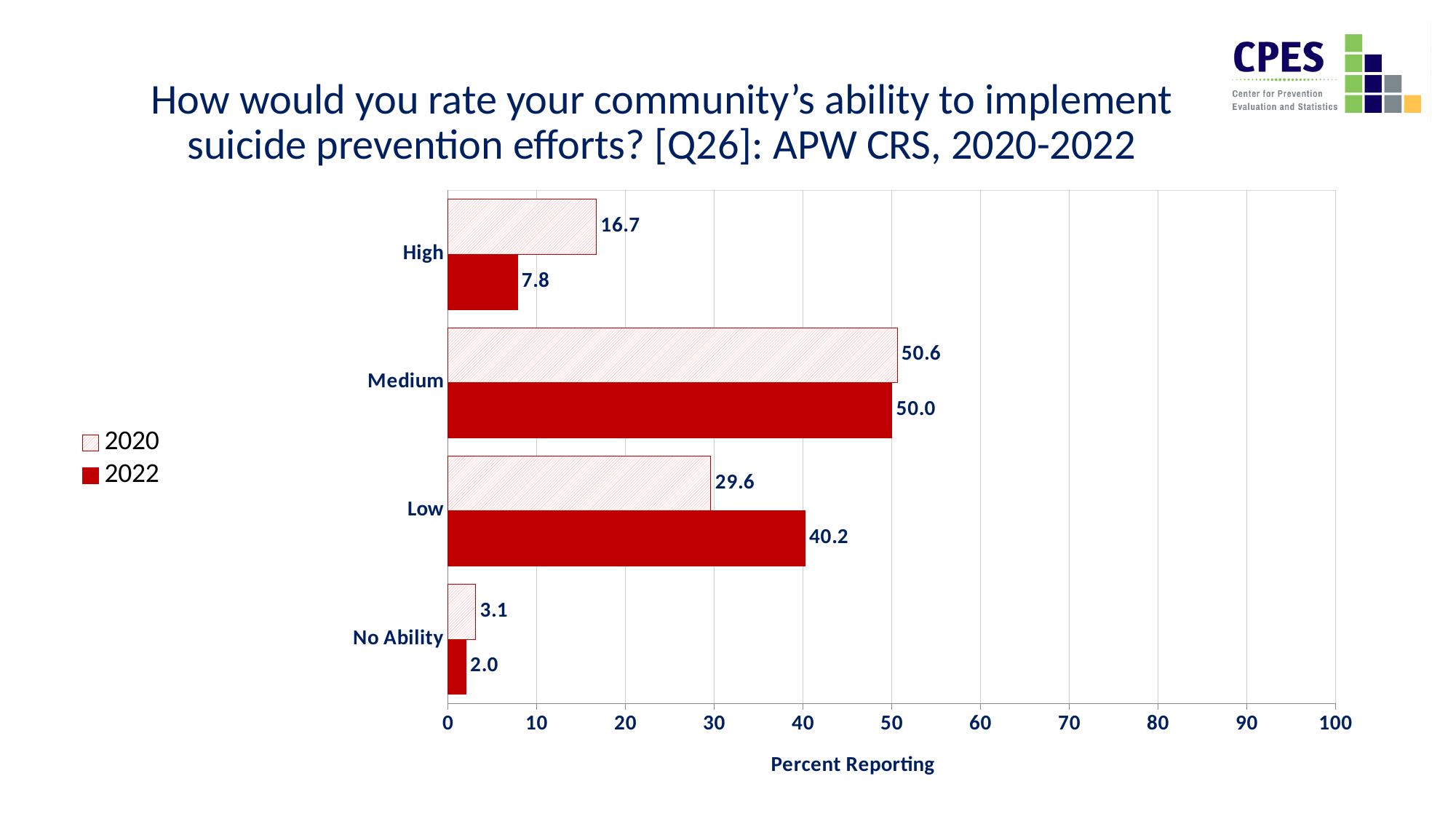
What kind of chart is shown on the slide? Bar chart How many categories are shown on the chart? 4 What is the difference between the 2022 and 2020 values for Low? 10.6 Which category has the lowest 2020 value? No Ability What is the 2022 value for Low? 40.2 What is the 2020 value for Medium? 50.6 What is the 2020 value for No Ability? 3.1 Which category has the highest 2022 value? Medium What is the 2022 value for High? 7.8 Which is larger for Low: the 2020 value or the 2022 value? 2022 What is the difference between the 2020 and 2022 values for High? 8.9 How many series does the legend list? 2